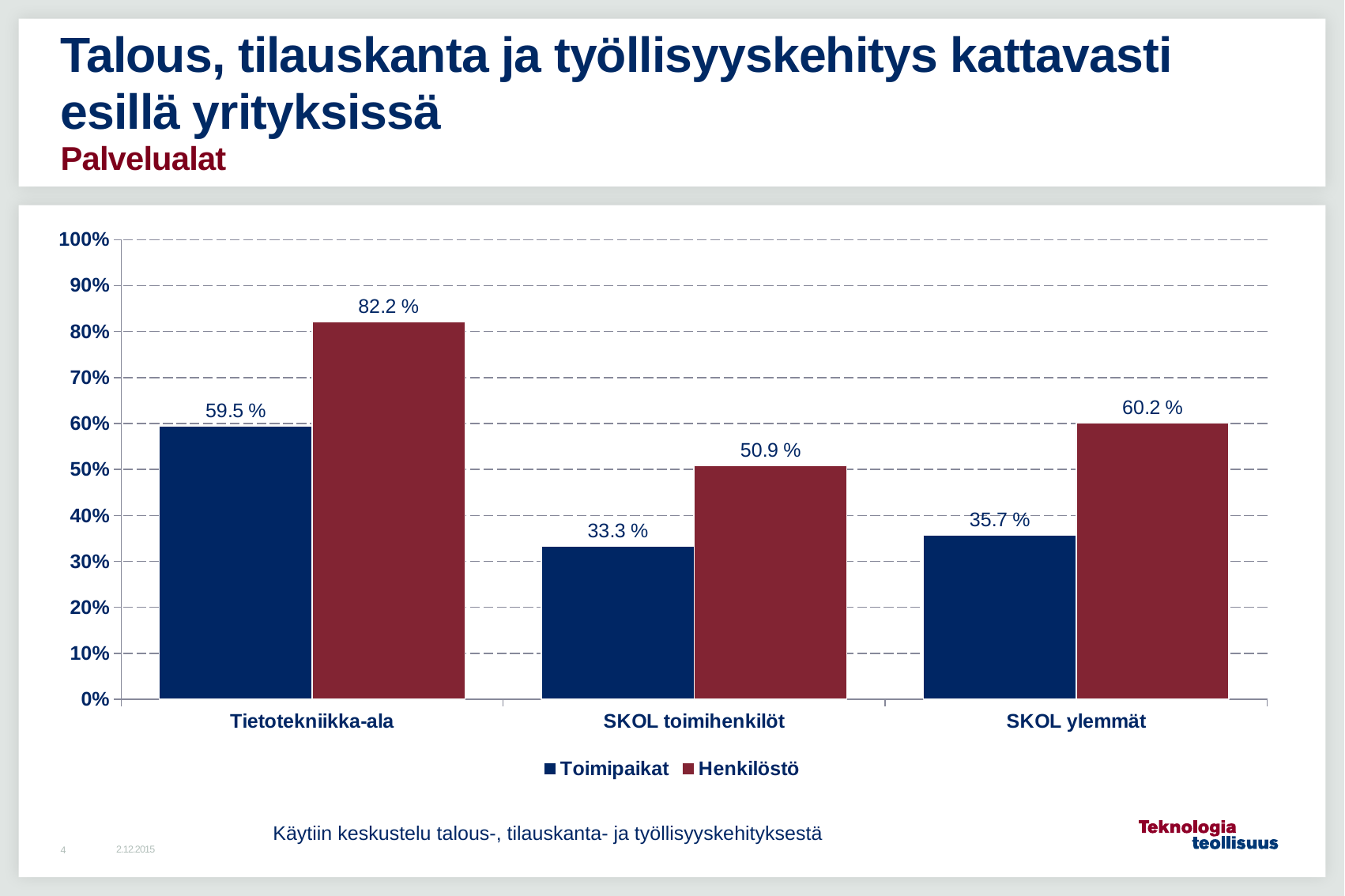
Which category has the lowest Toimipaikat value? SKOL toimihenkilöt Which is larger for SKOL ylemmät, Toimipaikat or Henkilöstö? Henkilöstö What is the Henkilöstö value for SKOL ylemmät? 60.2 % Which category has the highest Henkilöstö value? Tietotekniikka-ala How many series does the legend list? 2 What is the difference between the Henkilöstö and Toimipaikat values for Tietotekniikka-ala? 22.7 % What is the Toimipaikat value for Tietotekniikka-ala? 59.5 % What is the difference between the Henkilöstö values for Tietotekniikka-ala and SKOL toimihenkilöt? 31.3 % How many categories are shown on the x axis? 3 What is the Henkilöstö value for SKOL toimihenkilöt? 50.9 % Which series is shown in dark red? Henkilöstö What kind of chart is shown on the slide? Bar chart